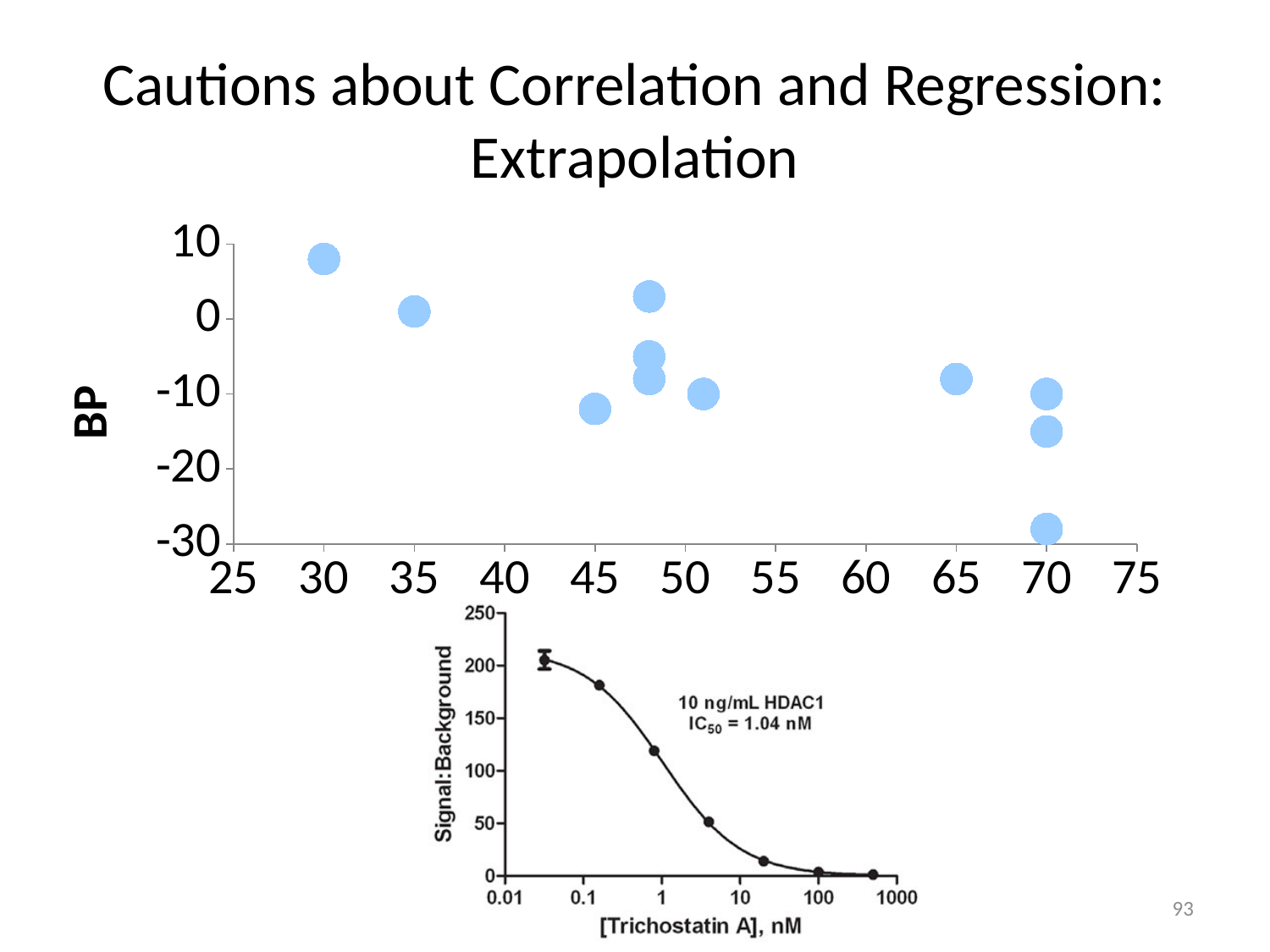
In the top scatter chart, how many data points are plotted? 11 In the top scatter chart, is the BP value of the point at x = 45 greater or less than -10? less In the bottom chart, does Signal:Background rise or fall as the Trichostatin A concentration increases? fall What kind of chart is the top chart on the slide? scatter chart In the top scatter chart, is the BP value of the lowest point at x = 70 greater or less than -20? less In the top scatter chart, at which x value is the point with the lowest BP located? 70 In the bottom chart, is the Signal:Background value at about 0.1 nM greater or less than 150? greater In the bottom chart, what is the label on the x axis? [Trichostatin A], nM In the top scatter chart, at which x value is the point with the highest BP located? 30 In the top scatter chart, what is the label on the y axis? BP In the top scatter chart, do the BP values generally rise or fall as the x value increases? fall